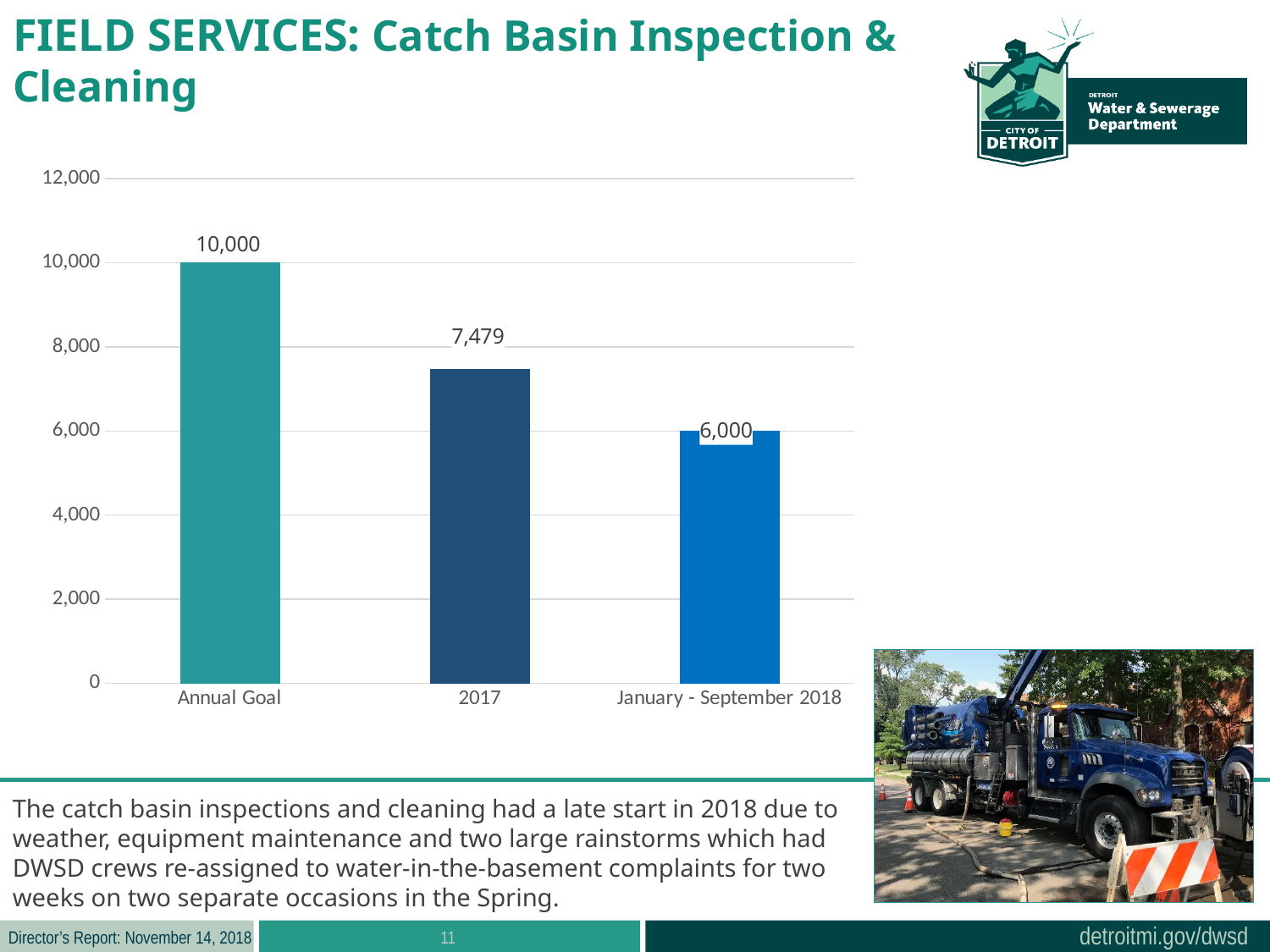
What is the value for Annual Goal? 10,000 Is the value for 2017 greater or less than 8,000? less Which category has the highest value? Annual Goal What is the difference between the 2017 value and the January - September 2018 value? 1,479 What is the value for January - September 2018? 6,000 Do the values rise or fall from left to right along the x axis? fall Which is larger, the value for 2017 or the value for January - September 2018? 2017 What is the difference between the Annual Goal and the 2017 value? 2,521 What is the value for 2017? 7,479 How many categories are shown on the chart? 3 What kind of chart is shown on the slide? bar chart Which category has the lowest value? January - September 2018